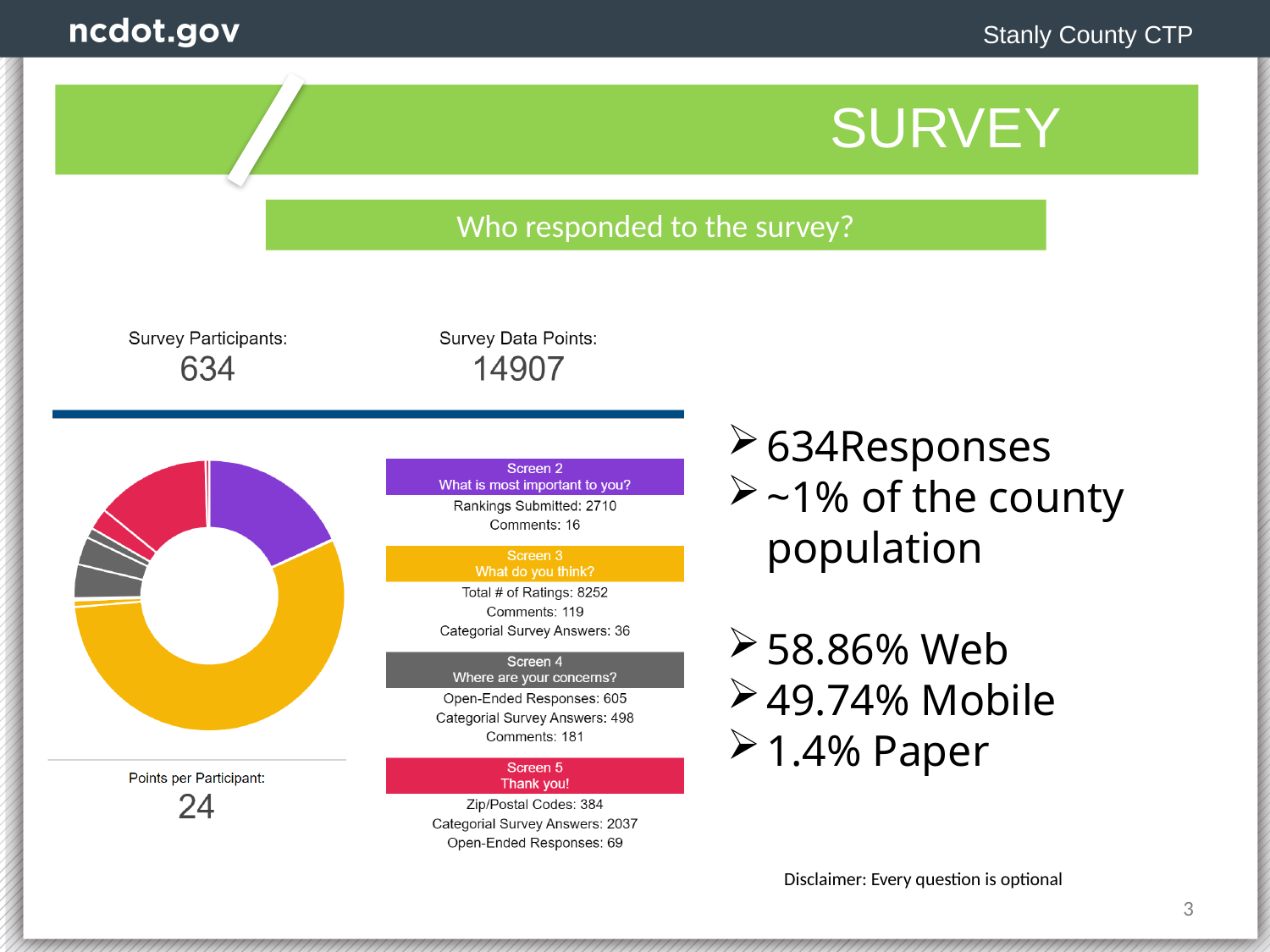
In the donut chart, which is larger: the purple slice or the red slice? Purple What value is printed for Survey Data Points above the donut chart? 14907 What value is printed for Survey Participants above the donut chart? 634 What kind of chart is shown on the left of the slide? Donut (pie) chart Which colour occupies the largest share of the donut chart? Yellow What value is printed for Points per Participant below the donut chart? 24 Does the donut chart have a legend? No Is the yellow slice of the donut chart greater or less than half of the chart? Greater In the donut chart, which is larger: the yellow slice or the purple slice? Yellow